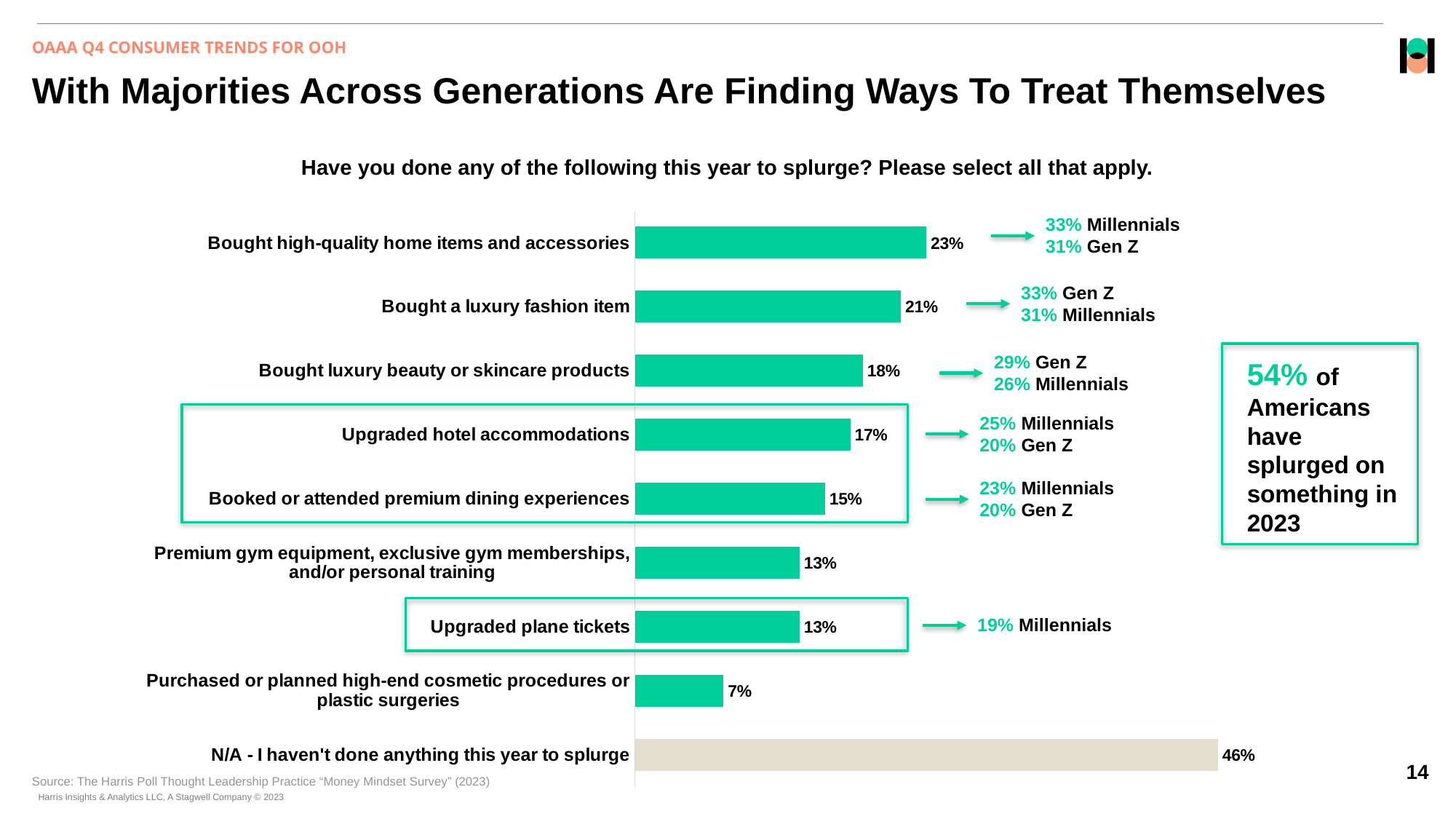
What percentage of respondents purchased or planned high-end cosmetic procedures or plastic surgeries? 7% What kind of chart is shown on the slide? Bar chart According to the annotation next to the chart, what percentage of Millennials upgraded plane tickets? 19% What percentage of respondents bought high-quality home items and accessories? 23% Which is larger: the percentage who booked or attended premium dining experiences or the percentage who upgraded plane tickets? Booked or attended premium dining experiences What percentage of respondents upgraded hotel accommodations? 17% What percentage of respondents said they haven't done anything this year to splurge? 46% What is the difference between the percentage who bought a luxury fashion item and the percentage who bought luxury beauty or skincare products? 3% Which category has the highest value in the chart? N/A - I haven't done anything this year to splurge According to the callout box on the slide, what percentage of Americans have splurged on something in 2023? 54% How many categories are shown in the chart? 9 Which category has the lowest value in the chart? Purchased or planned high-end cosmetic procedures or plastic surgeries